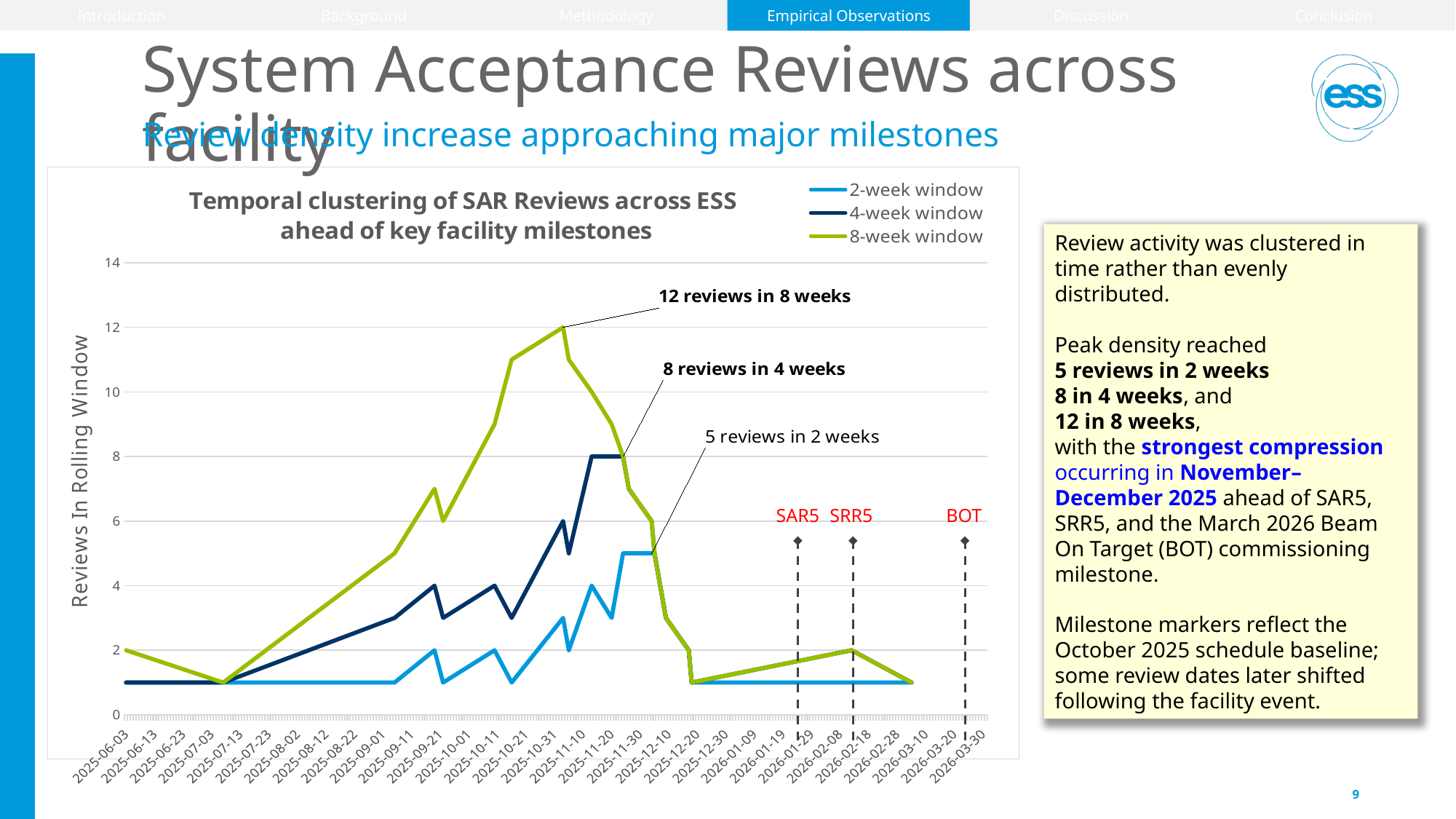
Does the 8-week window series rise or fall between 2025-10-31 and 2025-12-20? fall What is the difference between the peak of the 8-week window and the peak of the 4-week window? 4 What is the title of the chart? Temporal clustering of SAR Reviews across ESS ahead of key facility milestones What is the peak value of the 8-week window series, as labelled on the chart? 12 reviews in 8 weeks How many series does the chart legend list? 3 What is the peak value of the 4-week window series, as labelled on the chart? 8 reviews in 4 weeks At 2025-10-21, which is higher: the 8-week window or the 2-week window? 8-week window What kind of chart is shown on the slide? line chart Is the value of the 2-week window at 2025-11-20 greater or less than 4? less What is the peak value of the 2-week window series, as labelled on the chart? 5 reviews in 2 weeks Is the value of the 8-week window at 2025-10-21 greater or less than 10? greater